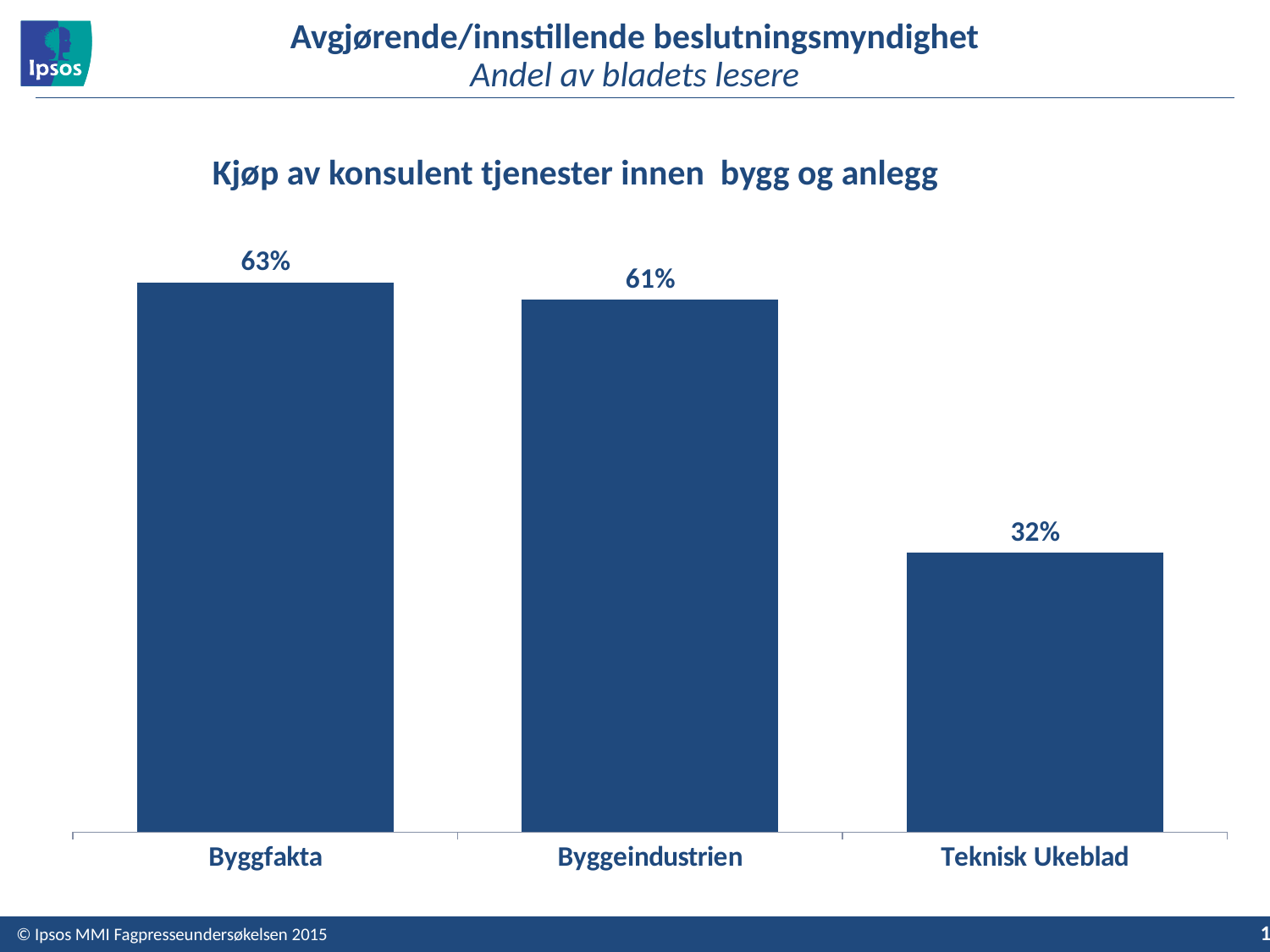
Which category has the lowest value? Teknisk Ukeblad What kind of chart is shown on the slide? Bar chart What is the value for Teknisk Ukeblad? 32% How many categories are shown in the chart? 3 What is the difference between the values for Byggfakta and Teknisk Ukeblad? 31% What colour are the bars in the chart? Dark blue What is the difference between the values for Byggeindustrien and Teknisk Ukeblad? 29% Which category has the highest value? Byggfakta What is the value for Byggfakta? 63% Which is larger, the value for Byggeindustrien or the value for Teknisk Ukeblad? Byggeindustrien What is the value for Byggeindustrien? 61% What is the title of the chart? Kjøp av konsulent tjenester innen bygg og anlegg